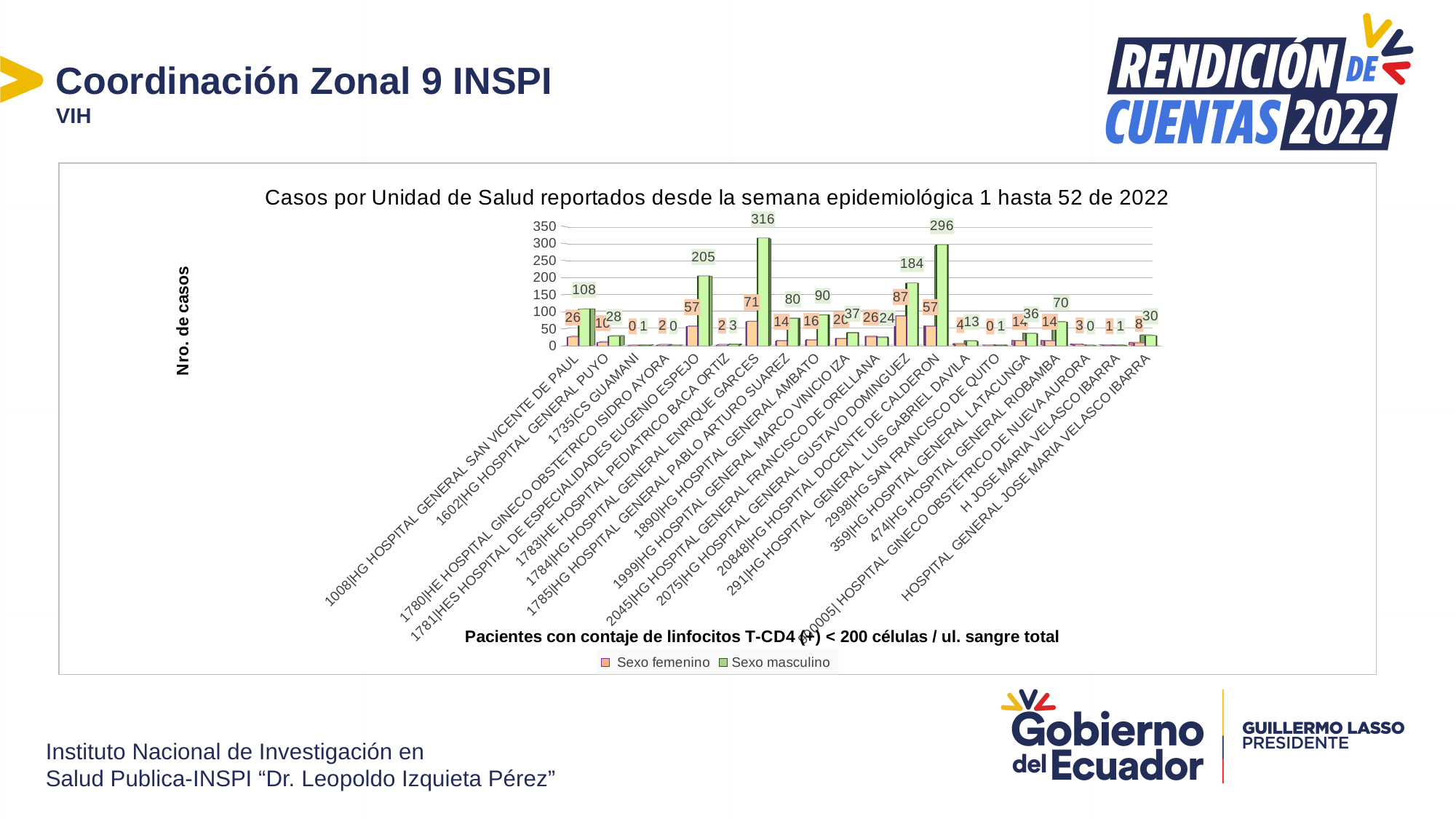
What is the title of the chart? Casos por Unidad de Salud reportados desde la semana epidemiológica 1 hasta 52 de 2022 What is the total of Sexo femenino and Sexo masculino at 1008|HG HOSPITAL GENERAL SAN VICENTE DE PAUL? 134 What is the value for Sexo masculino at 474|HG HOSPITAL GENERAL RIOBAMBA? 70 Which health unit has the highest Sexo masculino value? 1784|HG HOSPITAL GENERAL ENRIQUE GARCES What type of chart is shown on the slide? Bar chart What is the value for Sexo masculino at 1784|HG HOSPITAL GENERAL ENRIQUE GARCES? 316 How many series does the legend list? 2 Which is larger at 1781|HES HOSPITAL DE ESPECIALIDADES EUGENIO ESPEJO, Sexo femenino or Sexo masculino? Sexo masculino What is the value for Sexo masculino at 20848|HG HOSPITAL DOCENTE DE CALDERON? 296 Which health unit has the highest Sexo femenino value? 2075|HG HOSPITAL GENERAL GUSTAVO DOMINGUEZ What is the value for Sexo femenino at 2075|HG HOSPITAL GENERAL GUSTAVO DOMINGUEZ? 87 What is the difference between the Sexo masculino values for 1784|HG HOSPITAL GENERAL ENRIQUE GARCES and 20848|HG HOSPITAL DOCENTE DE CALDERON? 20